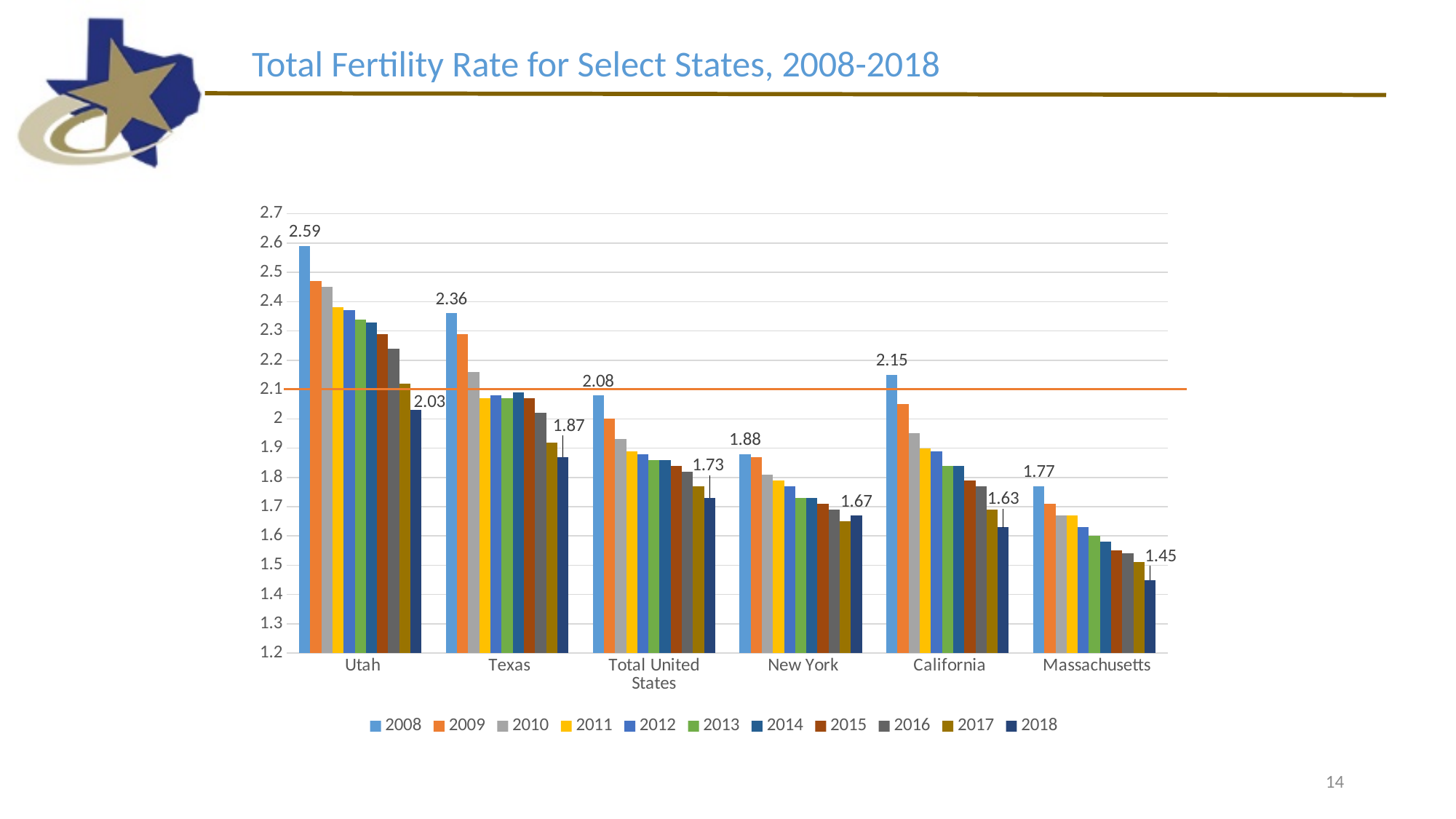
How many series does the legend list? 11 Within each state, do the values rise or fall from 2008 to 2018? Fall What is the difference between Utah's 2008 and 2018 total fertility rates? 0.56 What is the total fertility rate for Texas in 2018? 1.87 What is the 2018 value for California? 1.63 What is the 2008 value for Massachusetts? 1.77 Which state has the highest 2008 total fertility rate? Utah What kind of chart is shown on the slide? Bar chart Which is larger: the 2008 value for California or the 2008 value for Total United States? California Is the 2014 value for Texas greater or less than 2.0? greater Which category has the lowest 2018 total fertility rate? Massachusetts What is the total fertility rate for Utah in 2008? 2.59